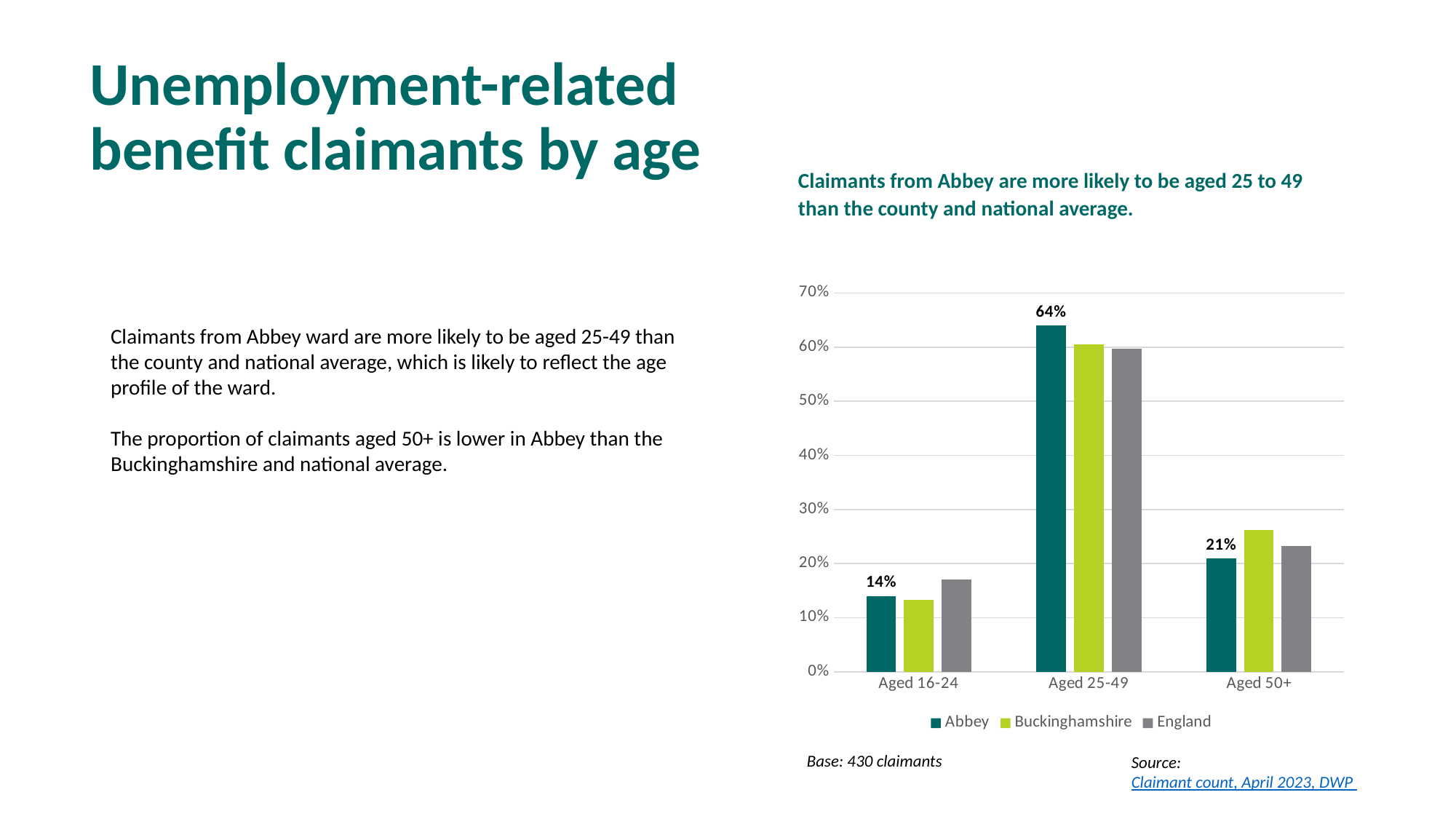
Is the England value for Aged 25-49 greater or less than 50%? greater Which age group has the highest share of Abbey claimants? Aged 25-49 What percentage of Abbey claimants are aged 50+? 21% For the Aged 50+ group, which is larger: the Abbey bar or the Buckinghamshire bar? Buckinghamshire Is the Buckinghamshire value for Aged 50+ greater or less than 30%? less For the Aged 25-49 group, which is larger: the Abbey bar or the England bar? Abbey What is the difference in percentage points between Abbey claimants aged 25-49 and those aged 50+? 43 percentage points Which age group has the lowest share of Abbey claimants? Aged 16-24 How many age groups are shown on the x axis of the chart? 3 What percentage of Abbey claimants are aged 16-24? 14% What percentage of Abbey claimants are aged 25-49? 64% How many series does the chart legend list? 3